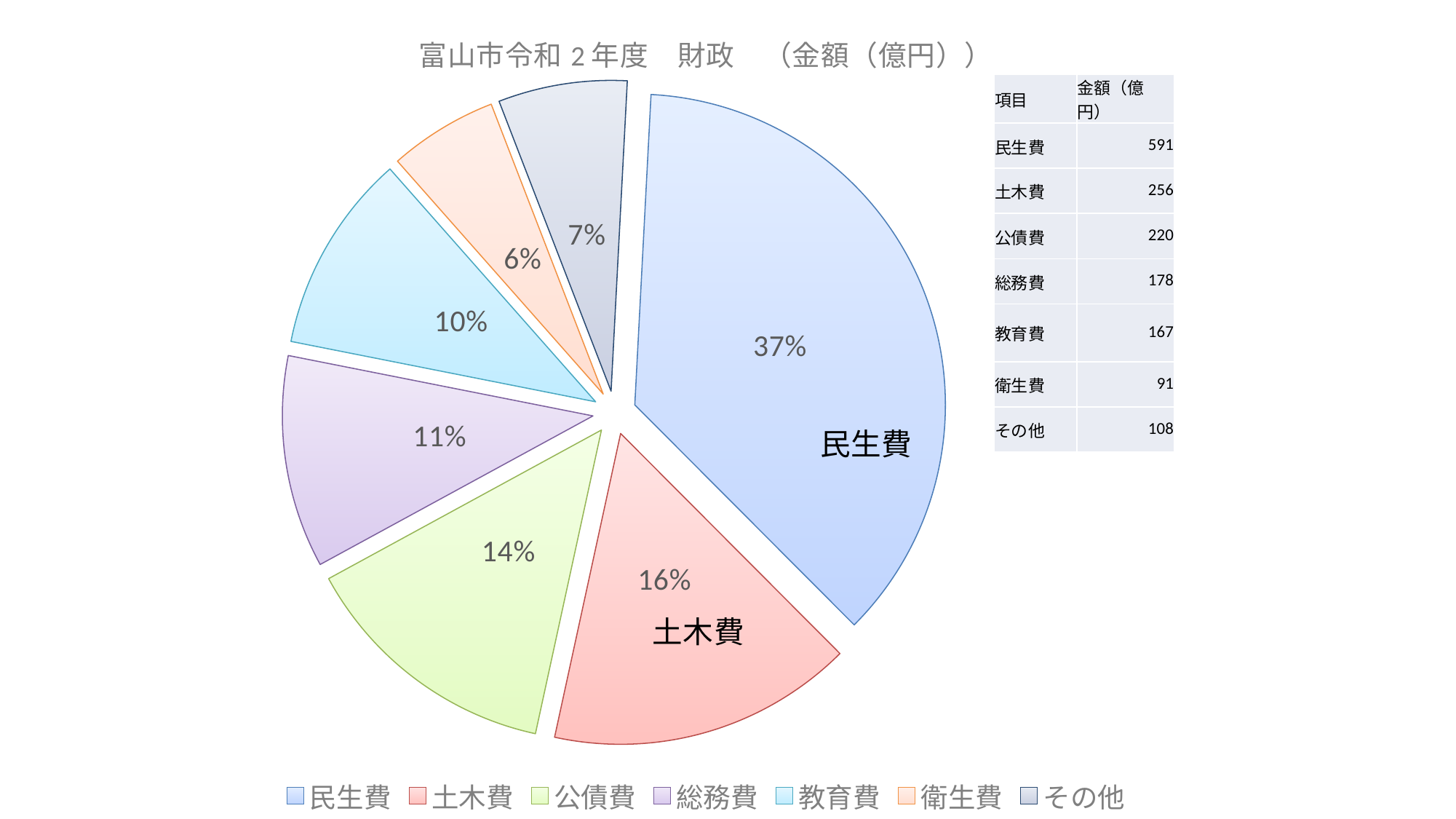
Which category has the largest slice of the pie? 民生費 How many categories does the pie chart have? 7 According to the table on the slide, what is the amount (億円) for その他? 108 What is the difference in amount (億円) between 民生費 and 土木費 according to the table? 335 Which has the larger amount, 総務費 or 教育費? 総務費 According to the table on the slide, what is the amount (億円) for 公債費? 220 Which category has the smallest slice of the pie? 衛生費 What share of the pie does 教育費 take? 10% What is the title of the chart? 富山市令和２年度 財政 （金額（億円）） What share of the pie does 土木費 take? 16% What kind of chart is shown on the slide? pie chart What share of the pie does 民生費 take? 37%